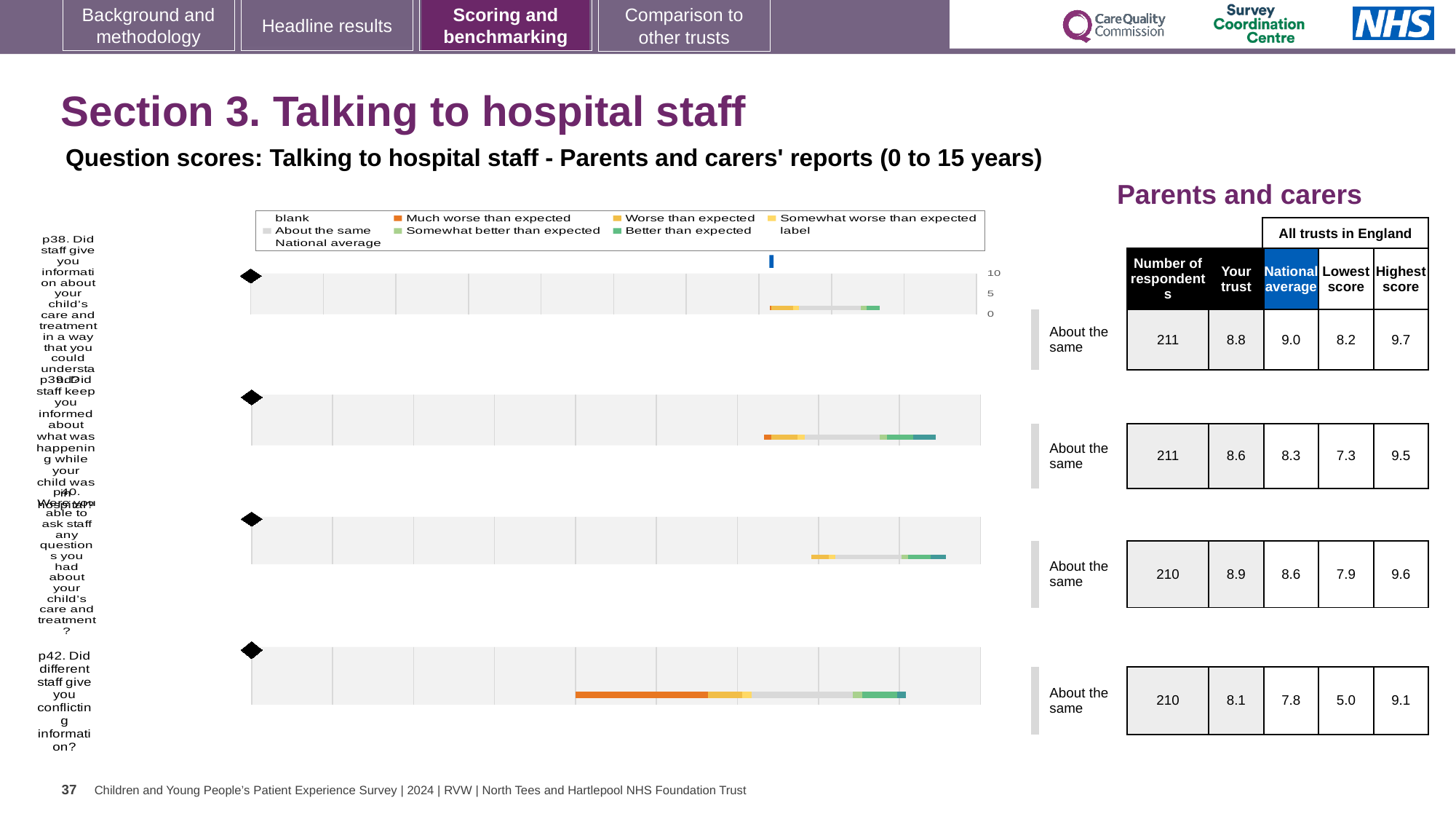
For question p38 (Did staff give you information about your child's care and treatment in a way that you could understand?), what is the number of respondents shown in the table? 211 For question p42 (Did different staff give you conflicting information?), what is the 'Your trust' score? 8.1 For question p42, what is the difference between the Highest score and the Lowest score? 4.1 What benchmark category is shown next to the chart for question p39? About the same How many questions (p38, p39, p40, p42) have a bar chart on this slide? 4 Which question has the lowest 'Your trust' score on this slide? p42 For question p40 (Were you able to ask staff any questions you had about your child's care and treatment?), what is the National average score? 8.6 What kind of chart is used to show the question scores on this slide? bar chart Which question has the highest 'Your trust' score on this slide? p40 For question p39 (Did staff keep you informed about what was happening while your child was in hospital?), what is the Highest score among all trusts in England? 9.5 For question p38, which is larger: the 'Your trust' score or the National average? National average For question p42, what is the Lowest score among all trusts in England? 5.0